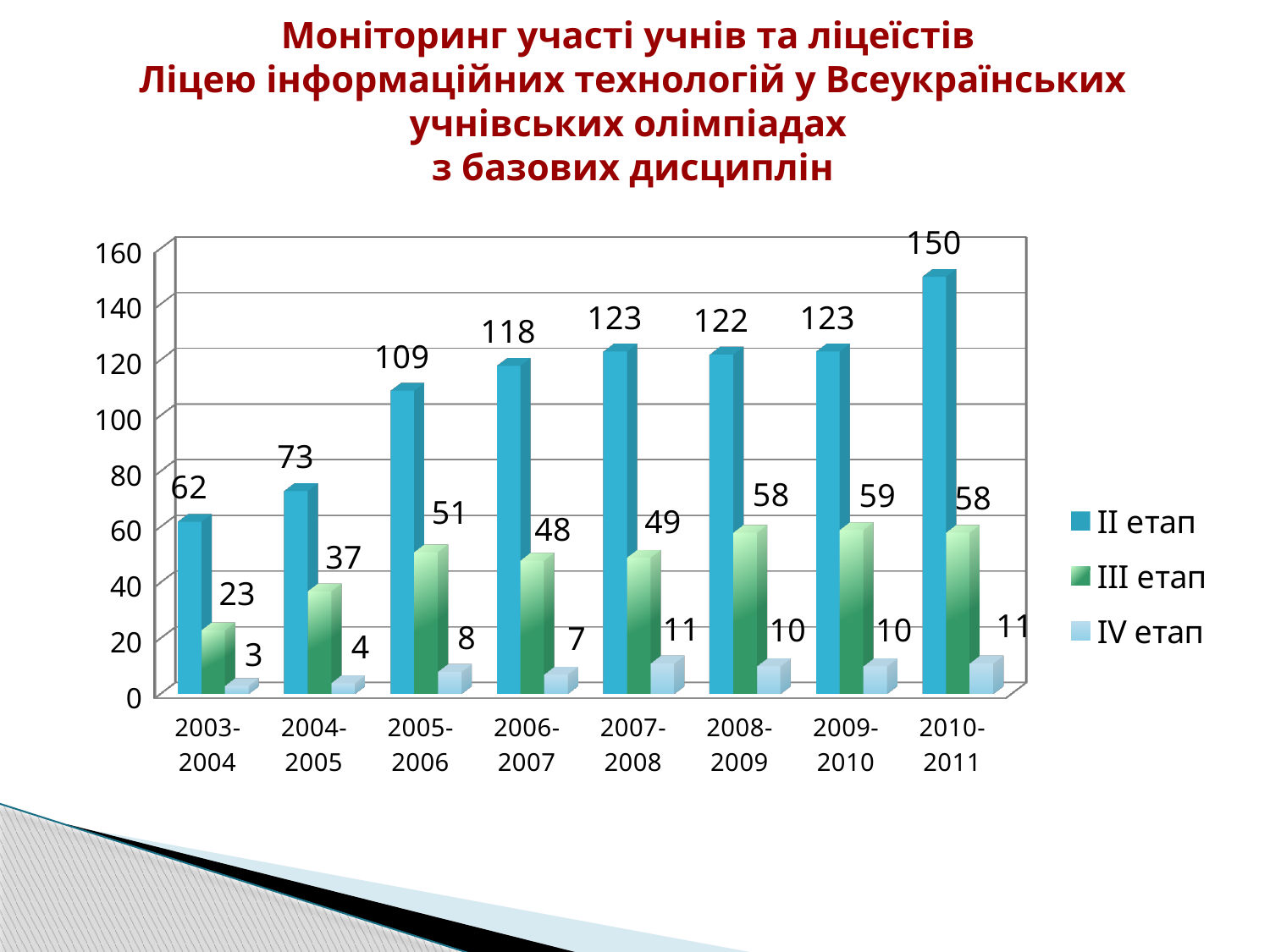
Which year has the lowest value for III етап? 2003-2004 What kind of chart is shown on the slide? bar chart What is the value for II етап in 2010-2011? 150 Does the II етап series generally rise or fall from 2003-2004 to 2010-2011? rise Is the value for II етап in 2005-2006 greater or less than 100? greater What is the difference between the II етап values for 2010-2011 and 2009-2010? 27 How many year categories are shown on the x axis? 8 How many series does the legend list? 3 What is the value for IV етап in 2003-2004? 3 Which year has the highest value for II етап? 2010-2011 What is the value for III етап in 2005-2006? 51 Which is larger: the III етап value for 2008-2009 or for 2007-2008? 2008-2009